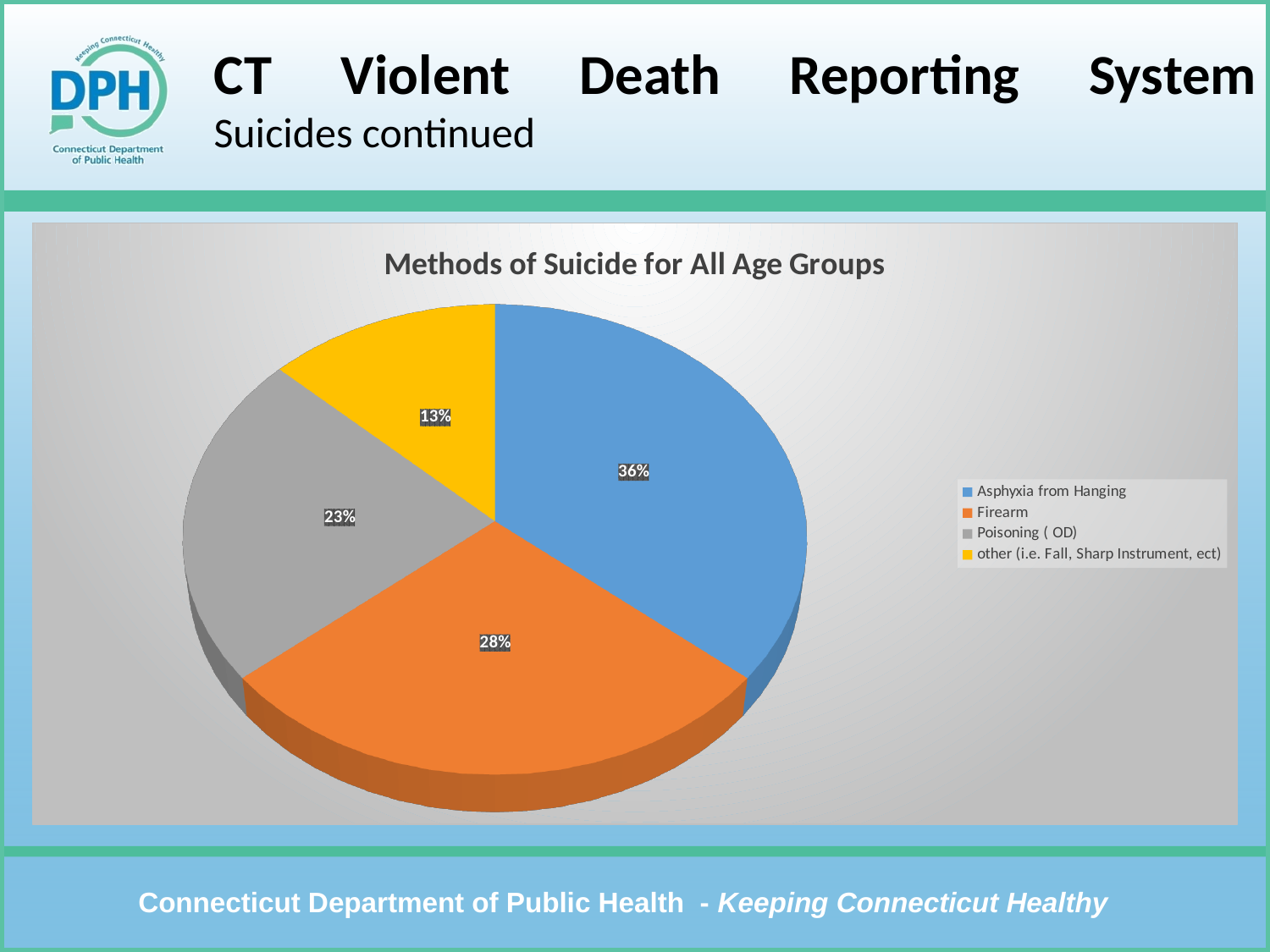
What percentage of suicides is attributed to Firearm? 28% Which method of suicide has the largest share of the pie? Asphyxia from Hanging What percentage of suicides is attributed to other (i.e. Fall, Sharp Instrument, ect)? 13% What colour is the slice for Poisoning ( OD)? Gray What is the title of the chart? Methods of Suicide for All Age Groups What percentage of suicides is attributed to Poisoning ( OD)? 23% Which is larger, the share for Firearm or the share for Poisoning ( OD)? Firearm What is the difference in percentage points between Asphyxia from Hanging and Firearm? 8 Which method of suicide has the smallest share of the pie? other (i.e. Fall, Sharp Instrument, ect) What type of chart is shown on the slide? Pie chart What percentage of suicides is attributed to Asphyxia from Hanging? 36% How many categories are shown in the pie chart? 4